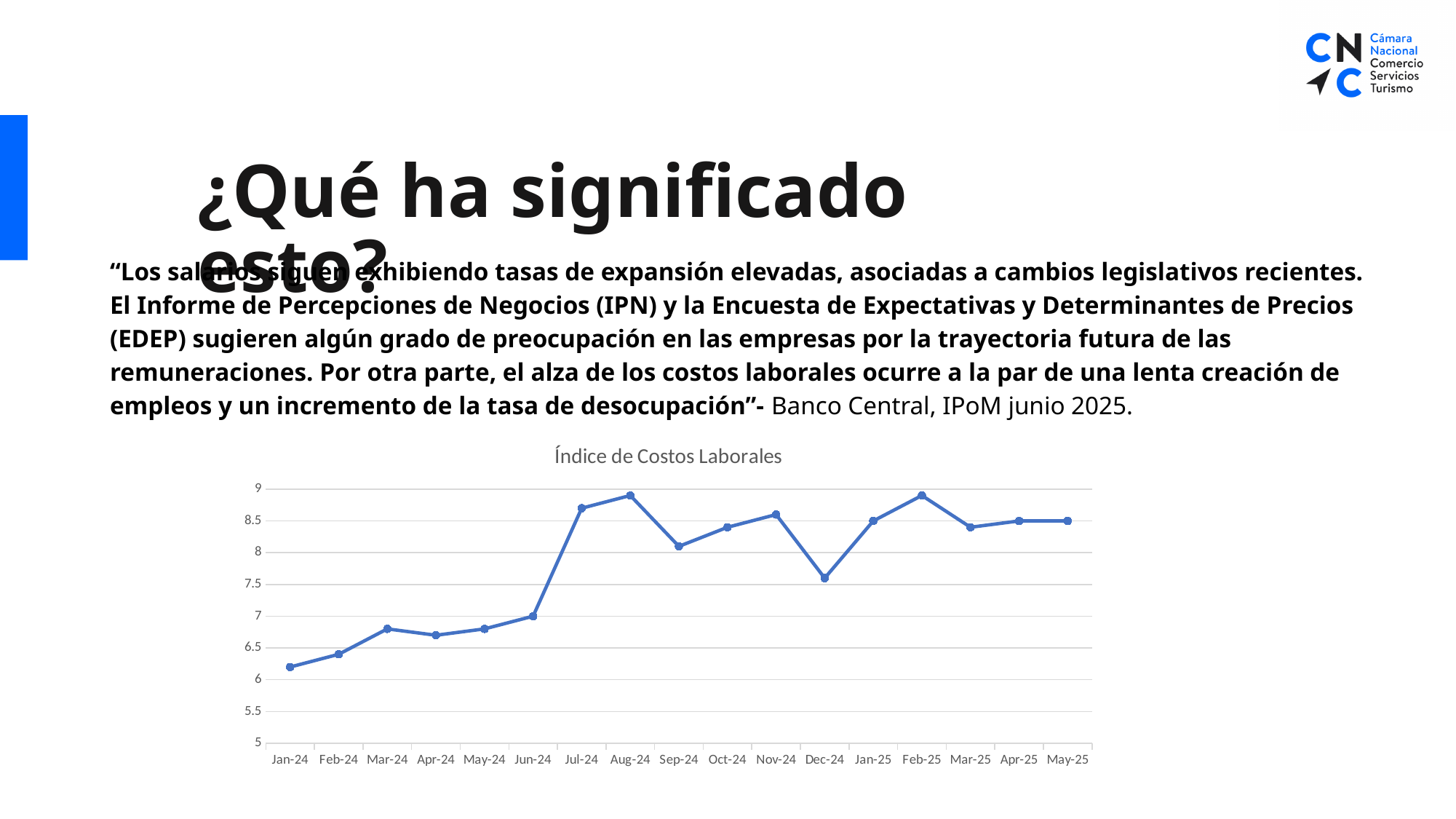
What type of chart is shown on the slide? line chart Which is larger, the value for Nov-24 or the value for Dec-24? Nov-24 Is the value for Dec-24 greater or less than 8? less Which is larger, the value for Aug-24 or the value for Sep-24? Aug-24 Which month has the lowest value on the chart? Jan-24 Overall, do the values rise or fall from Jan-24 to May-25? rise Is the value for Jan-24 greater or less than 6.5? less How many data points are plotted on the chart? 17 Is the value for Jul-24 greater or less than 8.5? greater Which is larger, the value for Jun-24 or the value for Jul-24? Jul-24 What is the title of the chart? Índice de Costos Laborales